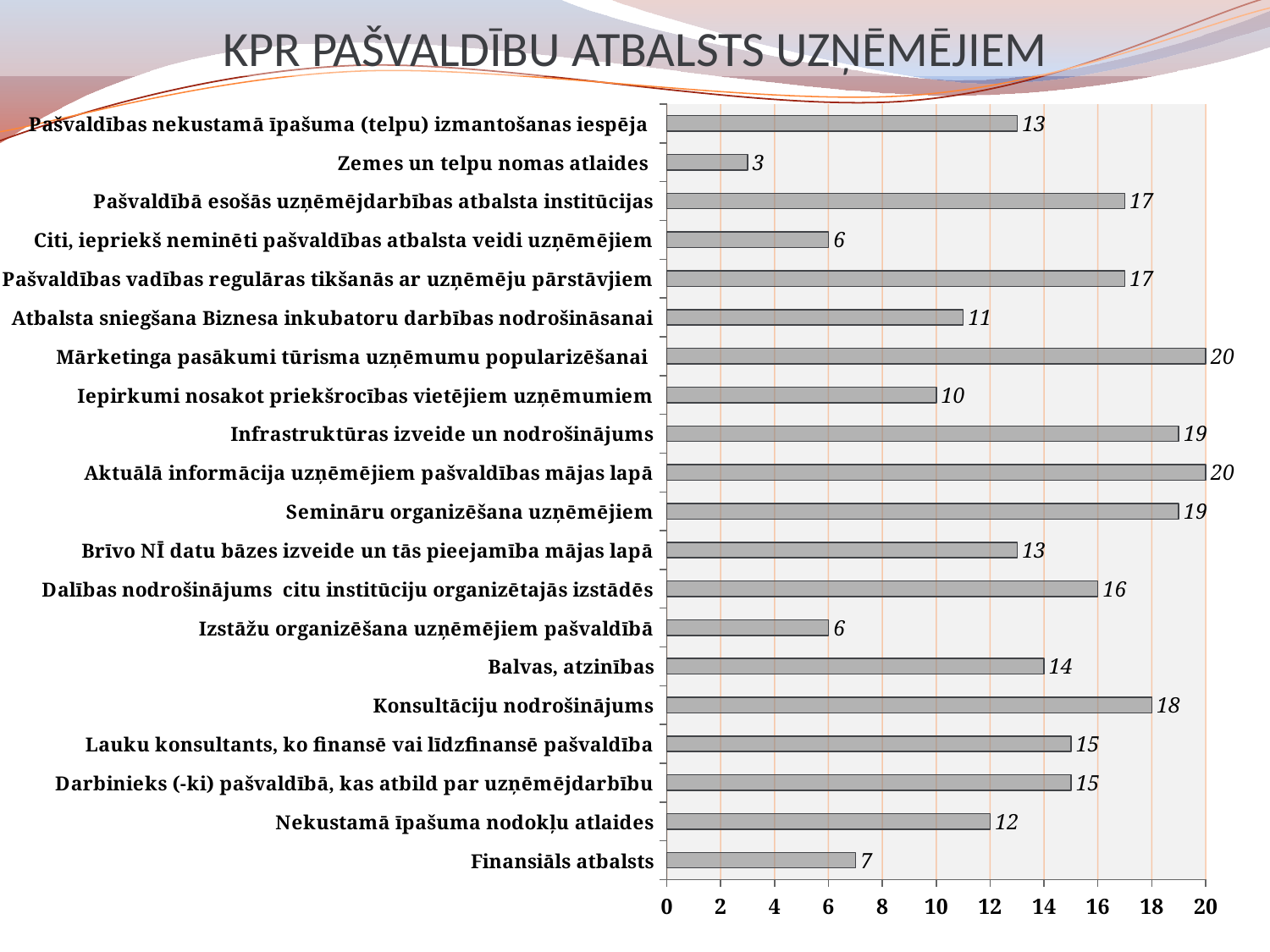
How many categories are shown in the chart? 20 What is the highest value shown in the chart? 20 What is the difference between the values for "Infrastruktūras izveide un nodrošinājums" and "Nekustamā īpašuma nodokļu atlaides"? 7 What is the title of the slide? KPR PAŠVALDĪBU ATBALSTS UZŅĒMĒJIEM Which category has the lowest value? Zemes un telpu nomas atlaides What is the value for "Konsultāciju nodrošinājums"? 18 What is the value for "Finansiāls atbalsts"? 7 What is the difference between the values for "Konsultāciju nodrošinājums" and "Finansiāls atbalsts"? 11 What is the value for "Balvas, atzinības"? 14 What kind of chart is shown on the slide? Bar chart What is the value for "Zemes un telpu nomas atlaides"? 3 Which is larger: the value for "Balvas, atzinības" or the value for "Nekustamā īpašuma nodokļu atlaides"? Balvas, atzinības